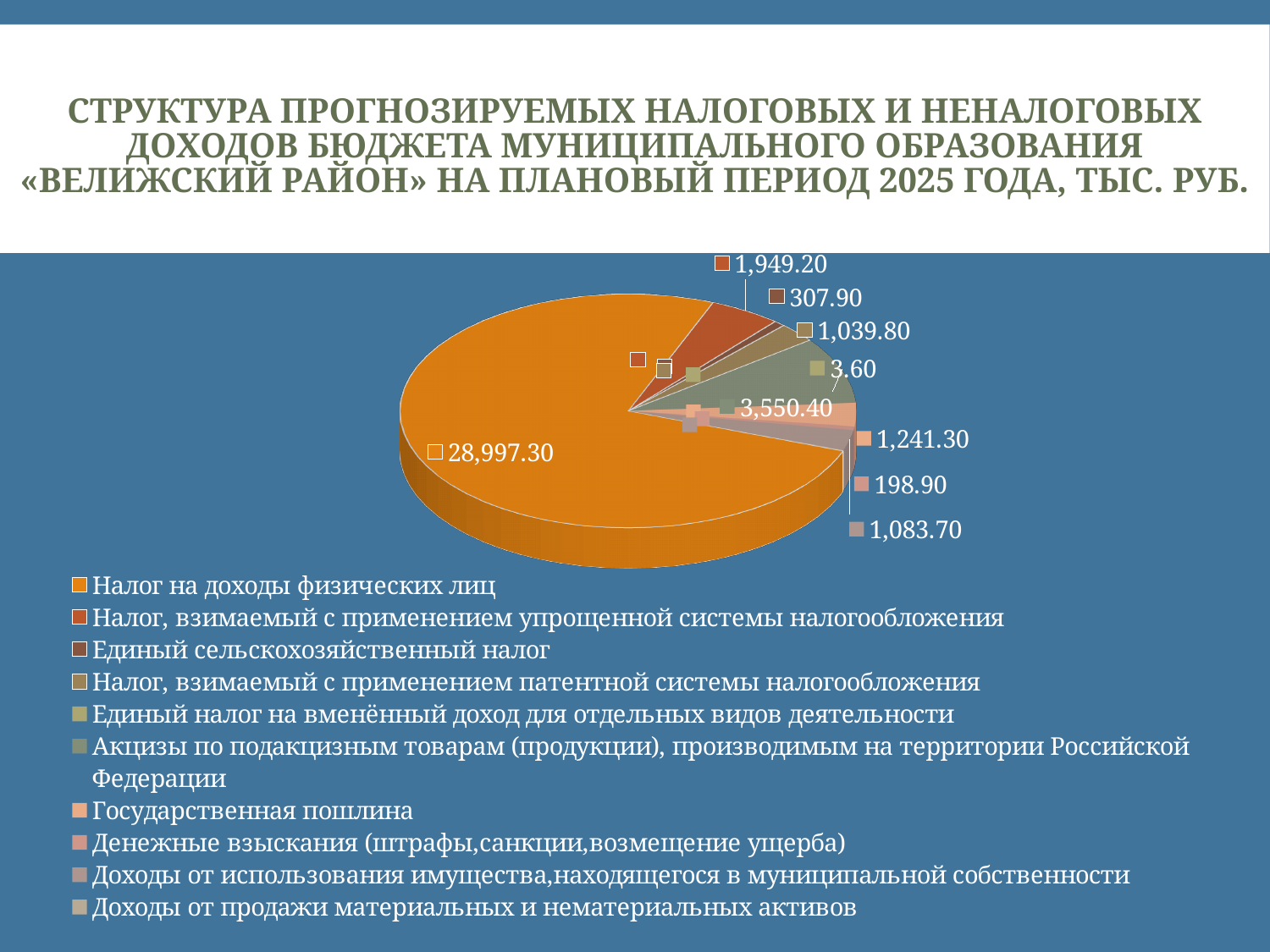
What is the difference between the slice labelled 1,241.30 and the slice labelled 198.90? 1,042.40 What is the value shown for Акцизы по подакцизным товарам (продукции), производимым на территории Российской Федерации? 3,550.40 How many categories does the legend of the pie chart list? 10 What is the value of the largest slice of the pie chart? 28,997.30 What is the difference between the slice labelled 1,949.20 and the slice labelled 307.90? 1,641.30 What is the smallest value labelled on the pie chart? 3.60 In what units are the values on the chart given, according to the slide title? тыс. руб. Which category has the largest slice of the pie chart? Налог на доходы физических лиц What kind of chart is shown on the slide? Pie chart Which is larger: the slice labelled 3,550.40 or the slice labelled 1,949.20? 3,550.40 What is the value shown for Единый сельскохозяйственный налог? 307.90 What is the value shown for Налог, взимаемый с применением упрощенной системы налогообложения? 1,949.20